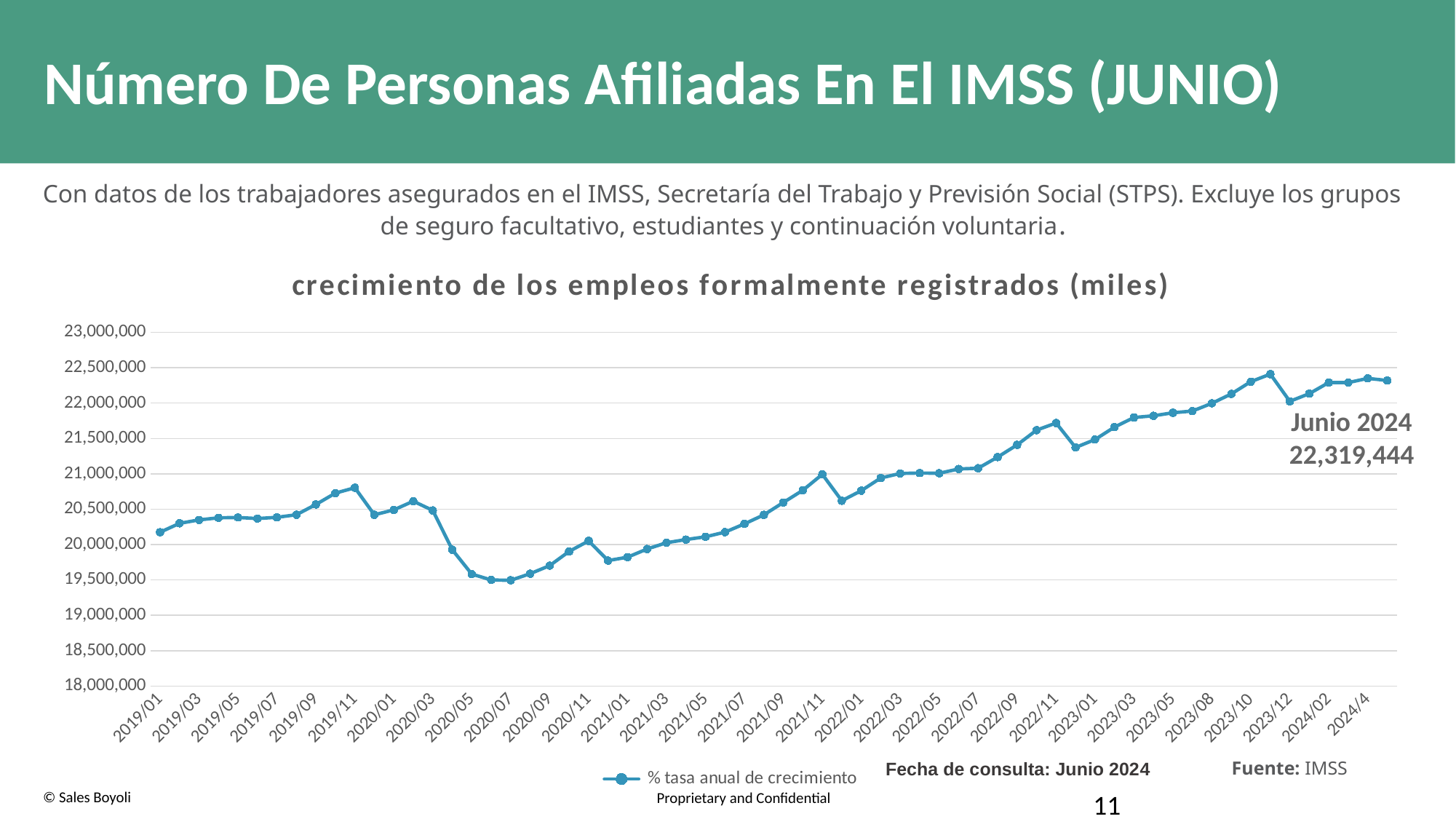
Which is larger, the value for 2019/11 or the value for 2020/07? 2019/11 Is the value for 2020/07 greater or less than 20,000,000? less Is the value for 2019/11 greater or less than 20,500,000? greater What kind of chart is shown on the slide? line chart What value is annotated for Junio 2024 on the chart? 22,319,444 What is the legend entry for the plotted series? % tasa anual de crecimiento Do the values rise or fall between 2020/03 and 2020/07? fall Overall, do the values rise or fall from 2019/01 to 2024/4? rise Is the value for 2023/10 greater or less than 22,000,000? greater How many series does the chart legend list? 1 What is the title of the chart? crecimiento de los empleos formalmente registrados (miles)